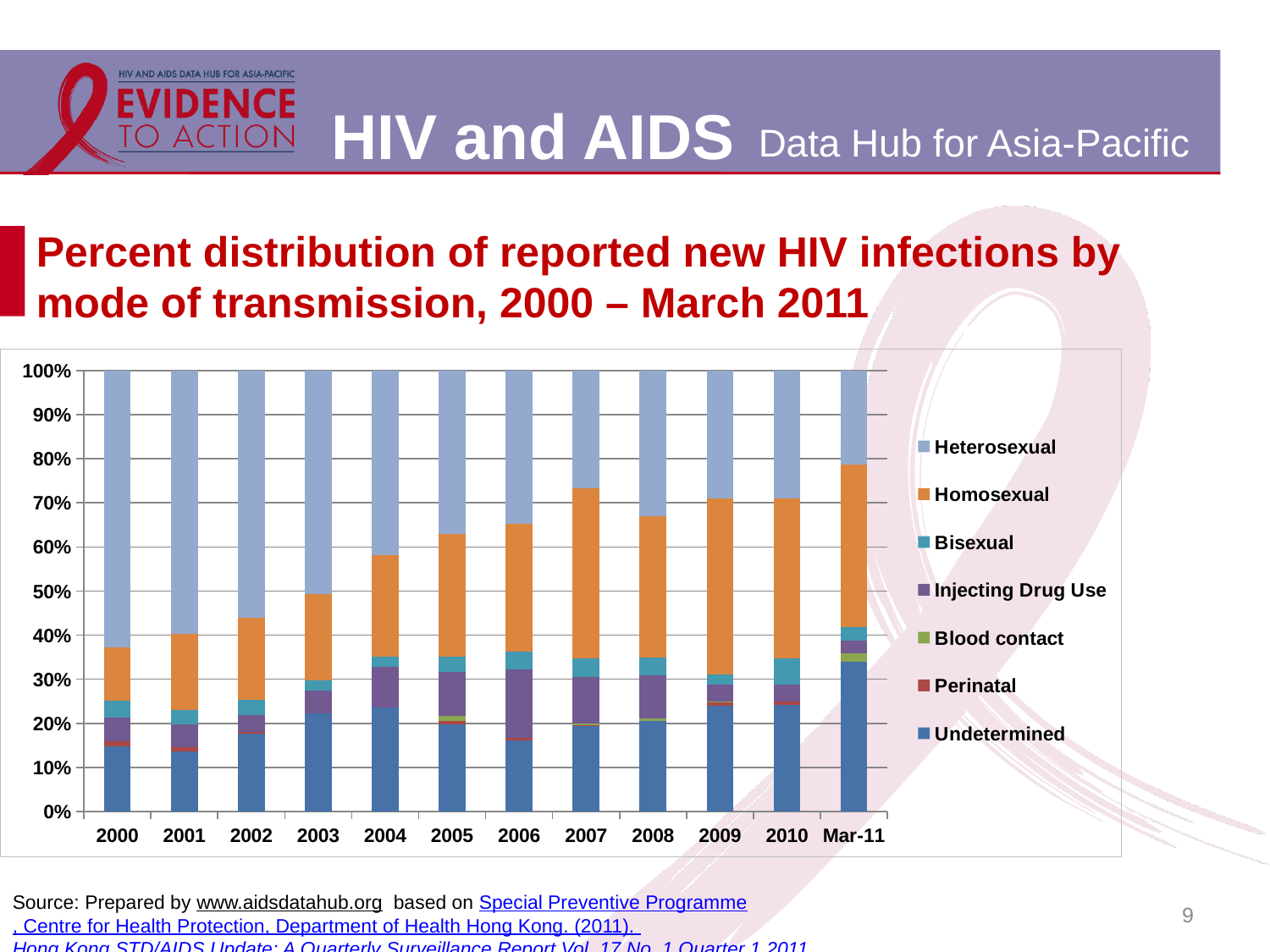
Which period has the largest Heterosexual share? 2000 How many time periods are shown along the x axis of the chart? 12 Which mode of transmission is listed first in the chart's legend? Heterosexual Is the Heterosexual share in 2000 greater or less than 50%? greater What kind of chart is shown on the slide? stacked bar chart Does the Heterosexual share generally rise or fall from 2000 to Mar-11? fall Is the Heterosexual share in Mar-11 greater or less than 30%? less Is the Undetermined share in Mar-11 greater or less than 30%? greater How many series does the chart's legend list? 7 Which period has the smallest Heterosexual share? Mar-11 What is the title of the chart on the slide? Percent distribution of reported new HIV infections by mode of transmission, 2000 – March 2011